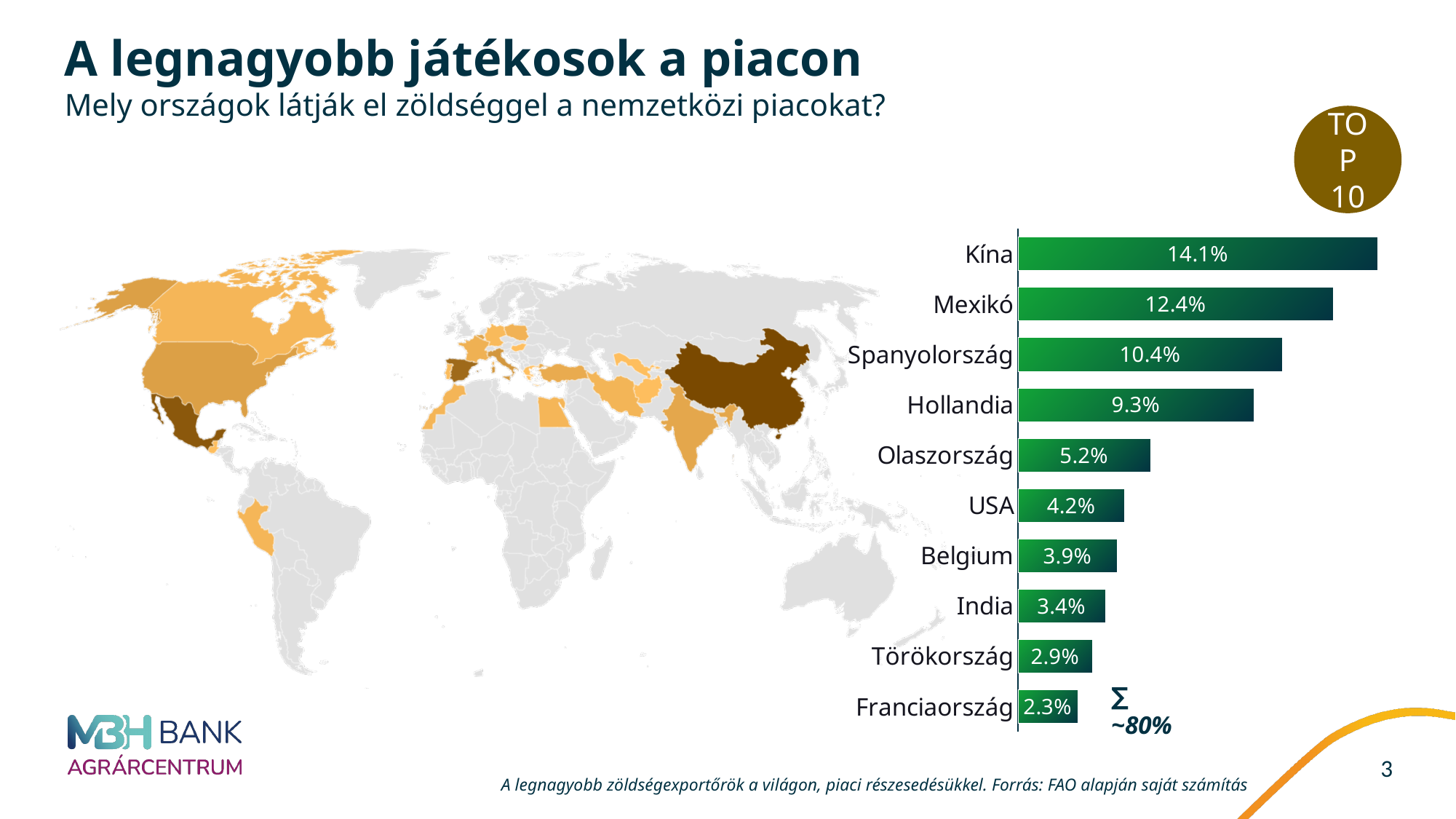
How many countries are shown in the bar chart? 10 Which country has the lowest value in the bar chart? Franciaország What is the value shown for USA in the bar chart? 4.2% What is the difference between the values for Spanyolország and Hollandia? 1.1 percentage points Which country has the highest value in the bar chart? Kína What kind of chart is used to show the countries' shares? Bar chart What is the value shown for Kína in the bar chart? 14.1% What is the value shown for Törökország in the bar chart? 2.9% What is the difference between the values for Kína and Mexikó? 1.7 percentage points Do the values in the bar chart increase or decrease from the top bar to the bottom bar? Decrease What is the value shown for Hollandia in the bar chart? 9.3% Which has a larger value, Belgium or India? Belgium